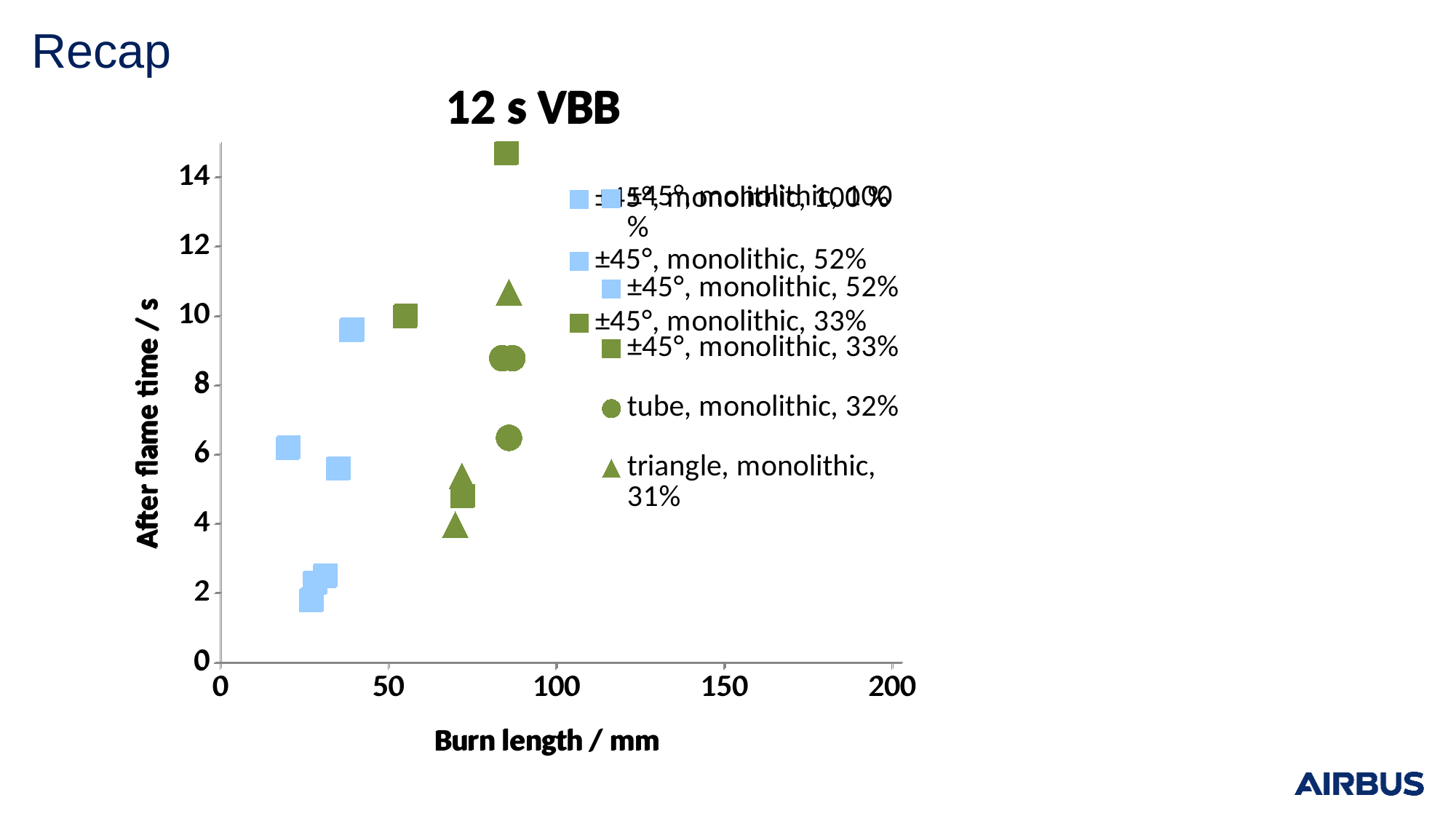
Is the lowest after flame time plotted on the chart greater or less than 4 s? less What kind of chart is shown on the slide? scatter chart What is the title of the chart? 12 s VBB Is the after flame time of the green triangle with the shortest burn length greater or less than 6 s? less Are all the blue square points at burn lengths less than 50 mm? yes Which markers have the shorter burn lengths, the blue squares or the green markers? blue squares What is the label of the x axis of the chart? Burn length / mm Which series contains the point with the highest after flame time? ±45°, monolithic, 33%